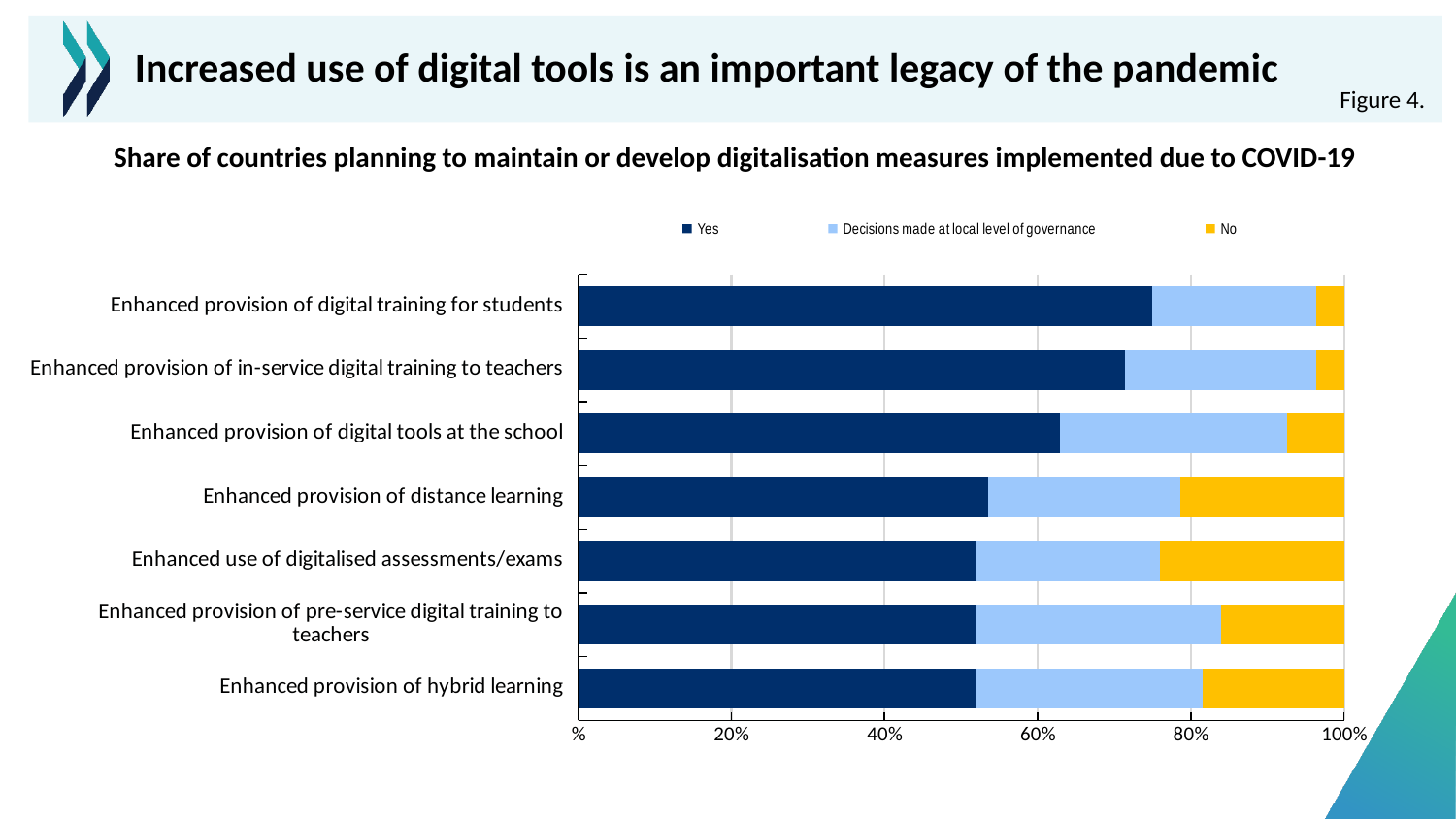
Which has a larger 'No' share: 'Enhanced use of digitalised assessments/exams' or 'Enhanced provision of digital training for students'? Enhanced use of digitalised assessments/exams Is the 'Yes' share for 'Enhanced provision of hybrid learning' greater or less than 60%? less Is the 'Yes' share for 'Enhanced provision of digital training for students' greater or less than 60%? greater How many categories (measures) are plotted on the chart? 7 What is the title of the chart? Share of countries planning to maintain or develop digitalisation measures implemented due to COVID-19 Is the 'Yes' share for 'Enhanced provision of in-service digital training to teachers' greater or less than 80%? less What kind of chart is shown on the slide? Stacked bar chart Which series is shown in yellow in the legend? No Which category has the largest 'Yes' share? Enhanced provision of digital training for students How many series does the legend list? 3 Which has a larger 'Yes' share: 'Enhanced provision of digital training for students' or 'Enhanced provision of distance learning'? Enhanced provision of digital training for students